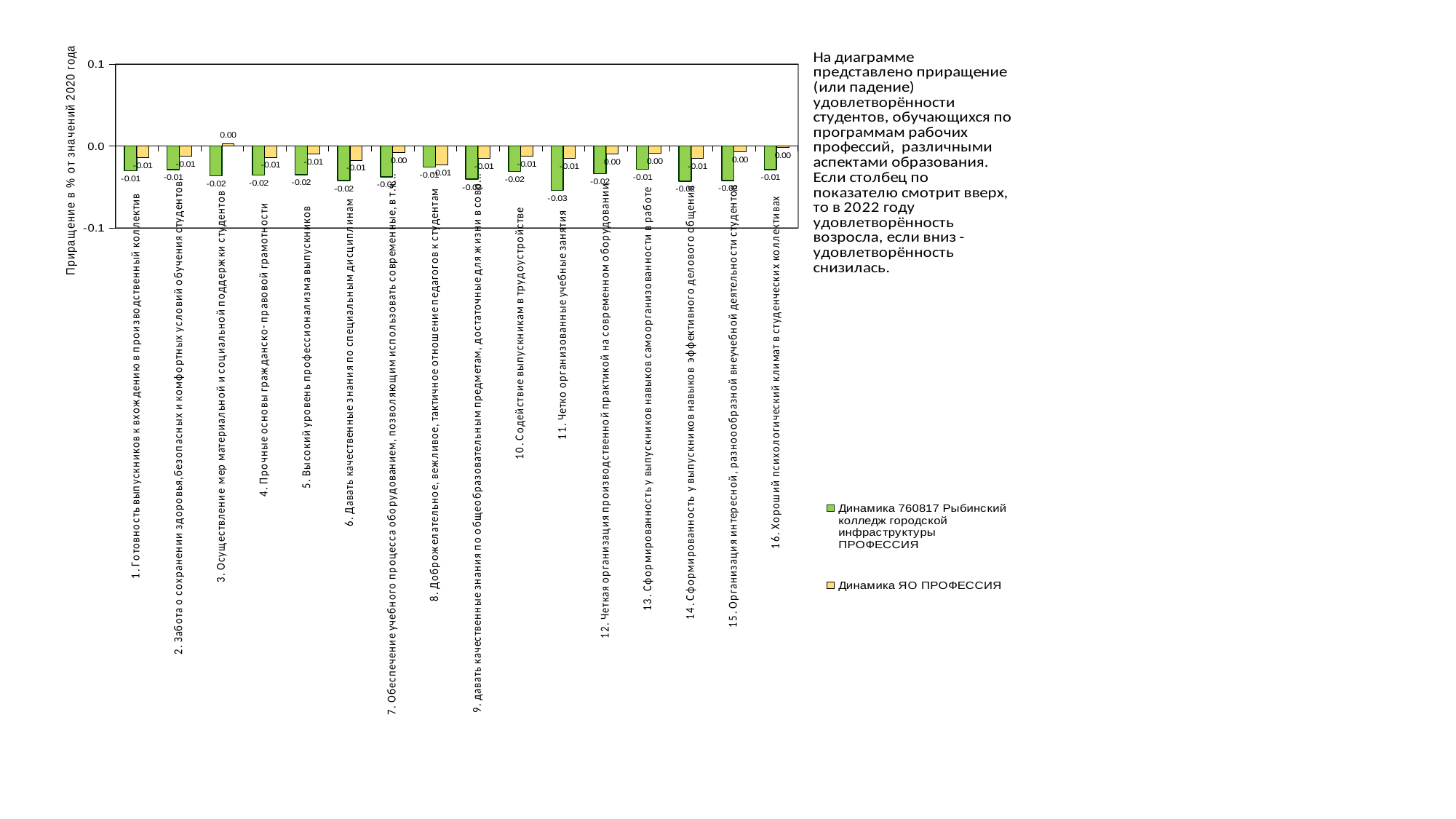
What is the title of the vertical axis? Приращение в % от значений 2020 года How many series does the legend list? 2 Which category has the lowest value for the series 'Динамика 760817 Рыбинский колледж городской инфраструктуры ПРОФЕССИЯ'? 11. Четко организованные учебные занятия What is the value of the series 'Динамика ЯО ПРОФЕССИЯ' for category '3. Осуществление мер материальной и социальной поддержки студентов'? 0.00 What kind of chart is shown on the slide? bar chart What is the value of the series 'Динамика ЯО ПРОФЕССИЯ' for category '16. Хороший психологический климат в студенческих коллективах'? 0.00 For category '11. Четко организованные учебные занятия', what is the difference between the value for 'Динамика ЯО ПРОФЕССИЯ' and the value for 'Динамика 760817 Рыбинский колледж городской инфраструктуры ПРОФЕССИЯ'? 0.02 What is the value of the series 'Динамика 760817 Рыбинский колледж городской инфраструктуры ПРОФЕССИЯ' for category '1. Готовность выпускников к вхождению в производственный коллектив'? -0.01 What is the value of the series 'Динамика 760817 Рыбинский колледж городской инфраструктуры ПРОФЕССИЯ' for category '11. Четко организованные учебные занятия'? -0.03 For category '11. Четко организованные учебные занятия', which series has the larger value? Динамика ЯО ПРОФЕССИЯ How many categories are plotted along the x axis? 16 What colour represents the series 'Динамика ЯО ПРОФЕССИЯ' in the legend? yellow